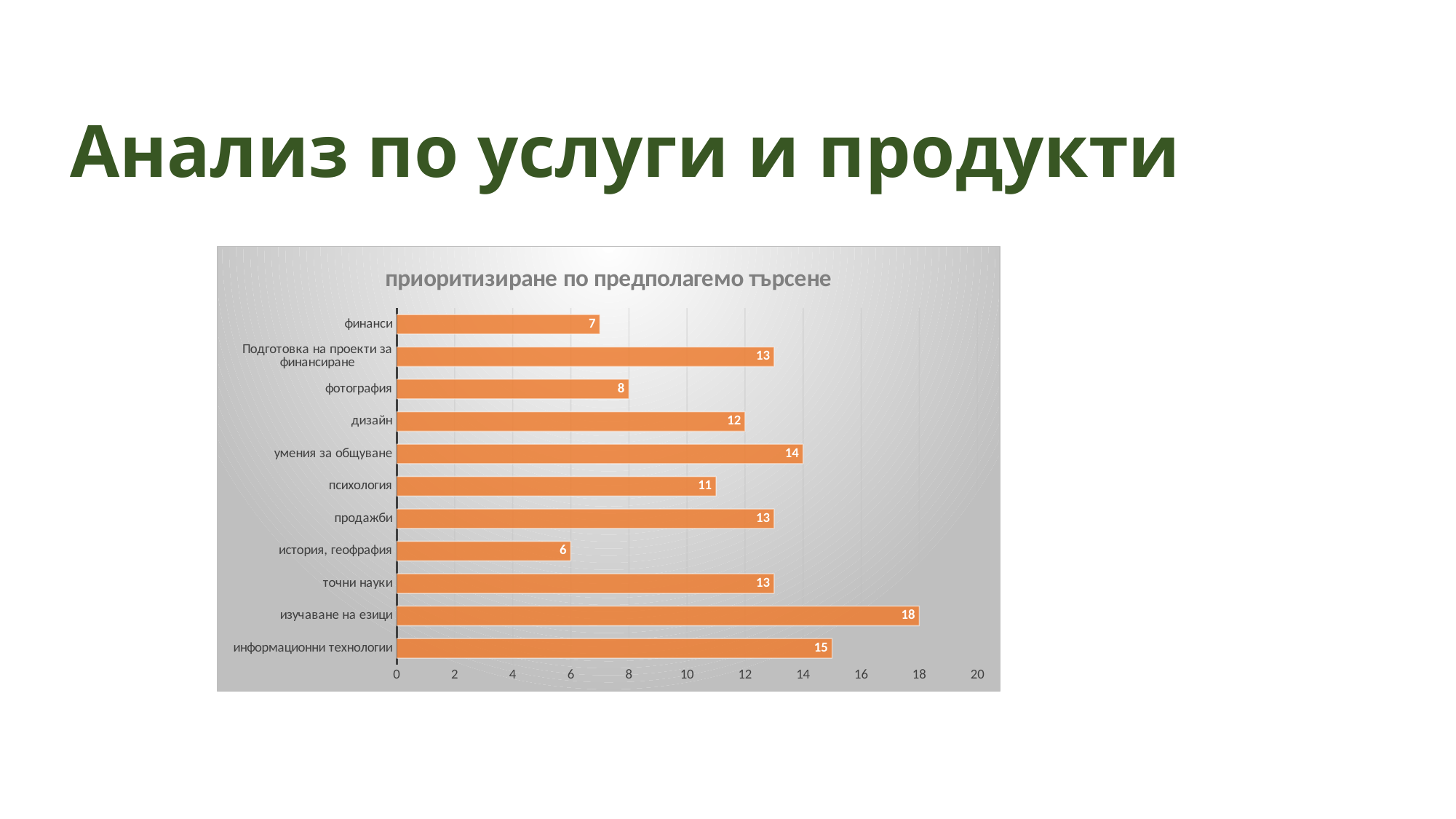
How many categories are shown in the chart? 11 Which category has the lowest value? история, геофрафия What colour are the bars in the chart? orange What is the title of the chart? приоритизиране по предполагемо търсене What is the difference between the values for информационни технологии and финанси? 8 Which is larger, the value for умения за общуване or the value for дизайн? умения за общуване What is the value for психология? 11 What kind of chart is shown on the slide? bar chart What is the value for Подготовка на проекти за финансиране? 13 Which category has the highest value? изучаване на езици Is the value for фотография greater or less than 10? less What is the value for изучаване на езици? 18